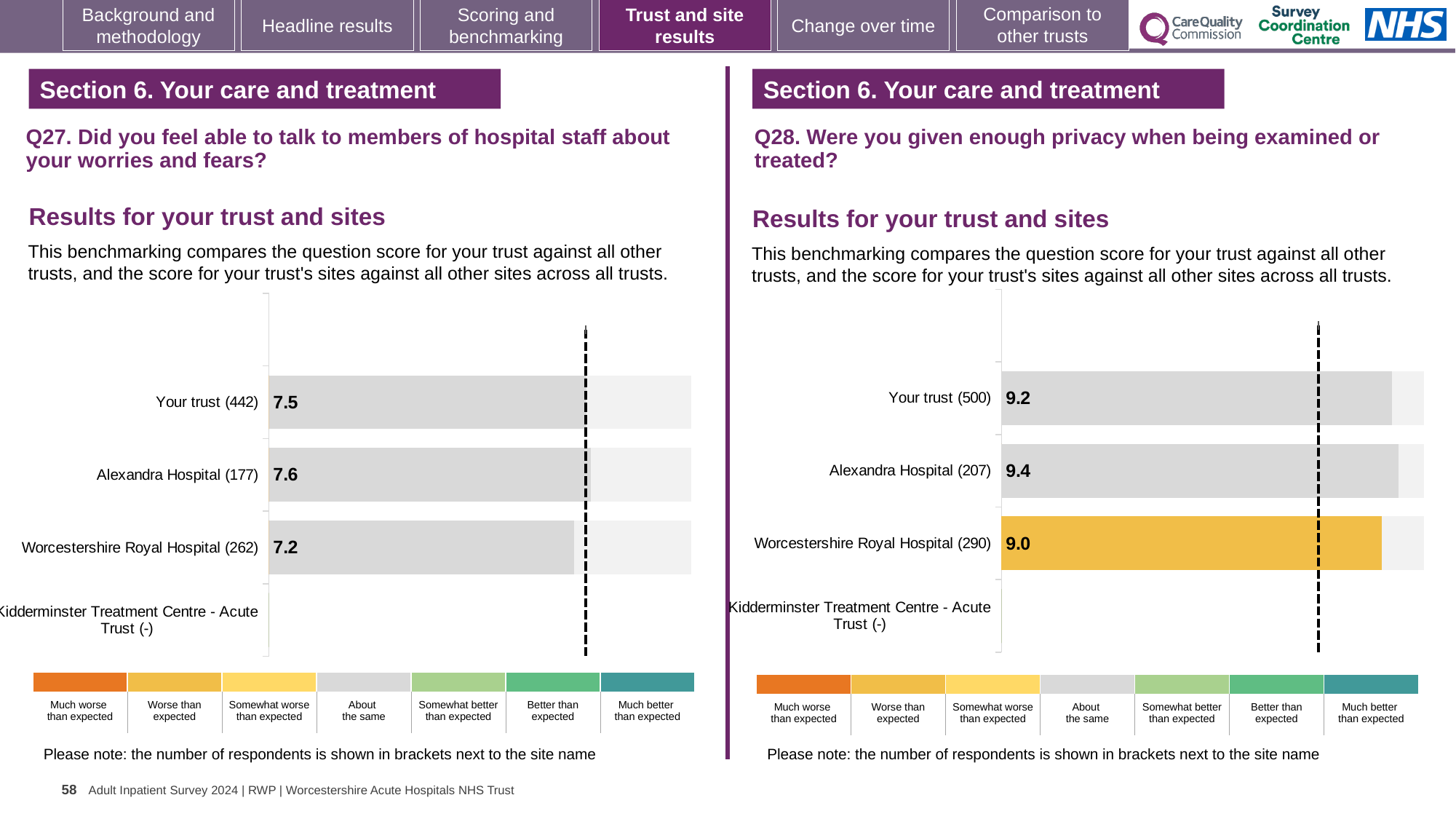
On the Q28 chart (right), which site's bar is coloured yellow/orange rather than grey? Worcestershire Royal Hospital On the Q28 chart (right), what is the score for Worcestershire Royal Hospital? 9.0 On the Q27 chart (left), what is the difference between the scores for Alexandra Hospital and Worcestershire Royal Hospital? 0.4 On the Q28 chart (right), which site or trust has the lowest score? Worcestershire Royal Hospital On the Q28 chart (right), what is the score for Alexandra Hospital? 9.4 On the Q27 chart (left), what is the score for Worcestershire Royal Hospital? 7.2 What kind of chart is used on the Q28 chart (right)? Bar chart On the Q27 chart (left), what is the score for Your trust? 7.5 On the Q28 chart (right), what is the difference between the scores for Alexandra Hospital and Your trust? 0.2 On the Q28 chart (right), which has the larger score, Your trust or Worcestershire Royal Hospital? Your trust On the Q27 chart (left), how many respondents are shown for Alexandra Hospital? 177 On the Q27 chart (left), which site or trust has the highest score? Alexandra Hospital